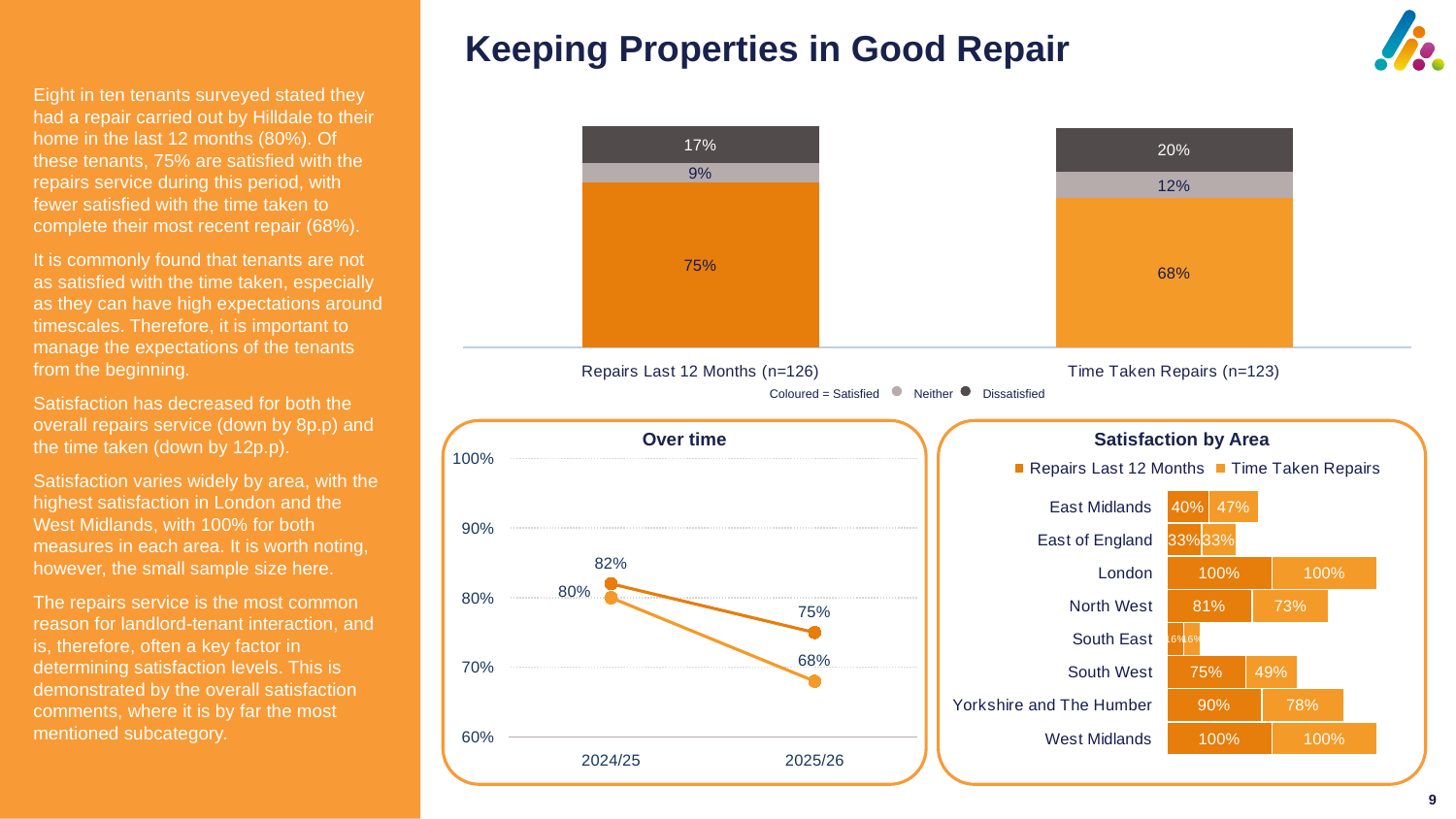
In the top stacked bar chart for Time Taken Repairs (n=123), what percentage of tenants answered Neither? 12% In the top stacked bar charts, what is the difference between the satisfied percentage for Repairs Last 12 Months and for Time Taken Repairs? 7 percentage points In the Over time chart, what is the highest value shown for 2024/25? 82% In the Satisfaction by Area chart, how many series does the legend list? 2 In the Satisfaction by Area chart, what is the Time Taken Repairs value for South West? 49% In the Over time chart, what is the lowest value shown for 2025/26? 68% In the top stacked bar chart for Repairs Last 12 Months (n=126), what percentage of tenants are satisfied? 75% In the Satisfaction by Area chart, what is the Repairs Last 12 Months value for Yorkshire and The Humber? 90% In the Over time chart, do the values rise or fall from 2024/25 to 2025/26? fall In the top stacked bar chart for Time Taken Repairs (n=123), what percentage of tenants are dissatisfied? 20% In the Satisfaction by Area chart, which is larger for North West: Repairs Last 12 Months or Time Taken Repairs? Repairs Last 12 Months In the Satisfaction by Area chart, how many areas are shown? 8